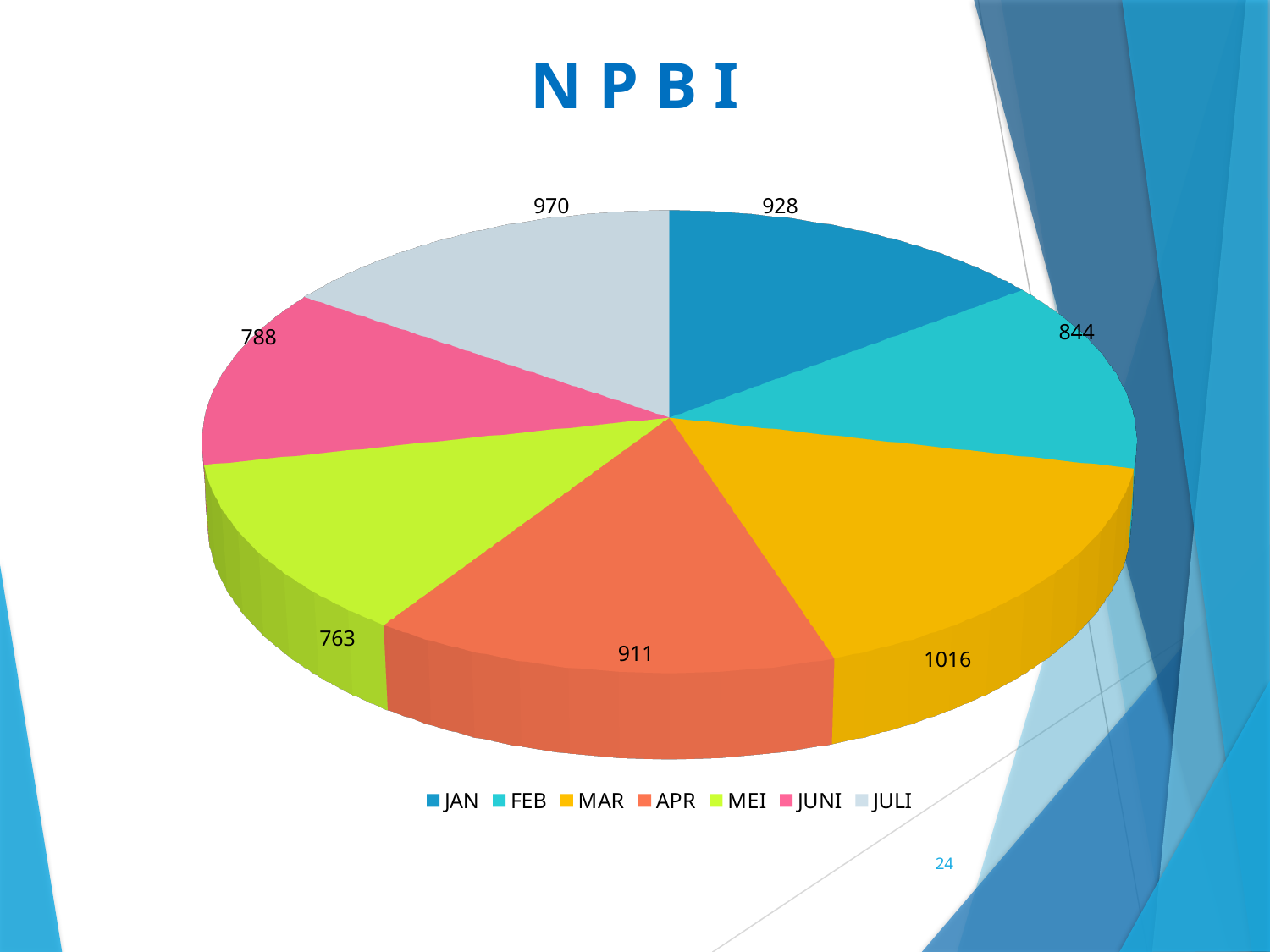
What is the difference between the values for MAR and MEI? 253 What is the value for JULI? 970 How many slices does the pie chart have? 7 What is the value for MAR? 1016 What is the difference between the values for JAN and FEB? 84 What type of chart is shown on the slide? Pie chart What is the value for MEI? 763 What colour is the slice for APR? Orange What is the title of the chart? N P B I Which is larger, the value for JUNI or the value for APR? APR Which month has the lowest value? MEI Which month has the highest value? MAR